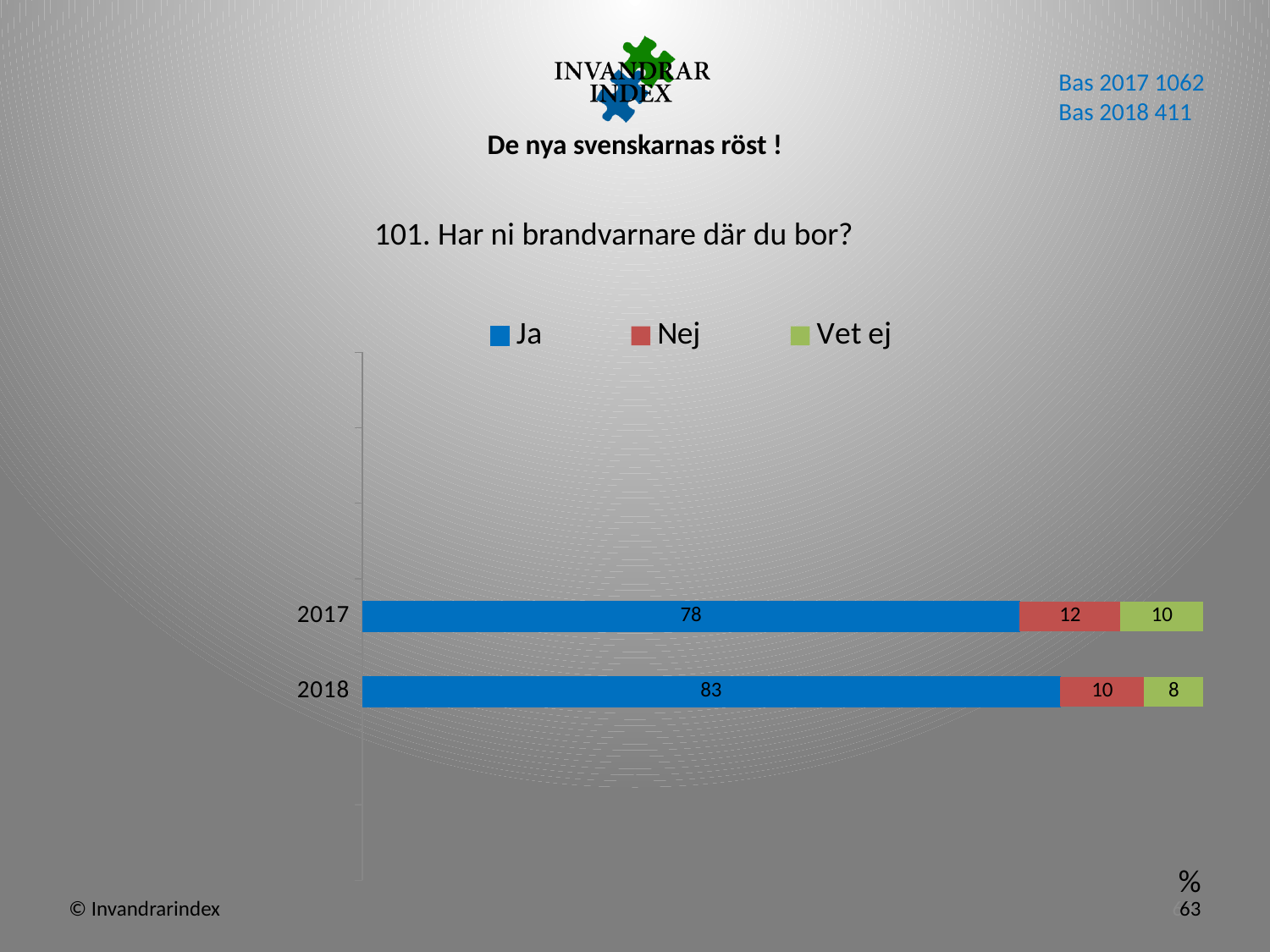
What is the value for Ja in 2017? 78 How many series does the legend list? 3 What is the value for Nej in 2017? 12 What is the total of the stacked bar for 2017? 100 What is the difference between the Ja values for 2018 and 2017? 5 What is the value for Ja in 2018? 83 What is the title of the chart? 101. Har ni brandvarnare där du bor? Which year has the higher value for Ja? 2018 What kind of chart is shown? bar chart Is the value for Nej larger in 2017 or in 2018? 2017 Which year has the lower value for Vet ej? 2018 What is the value for Vet ej in 2018? 8